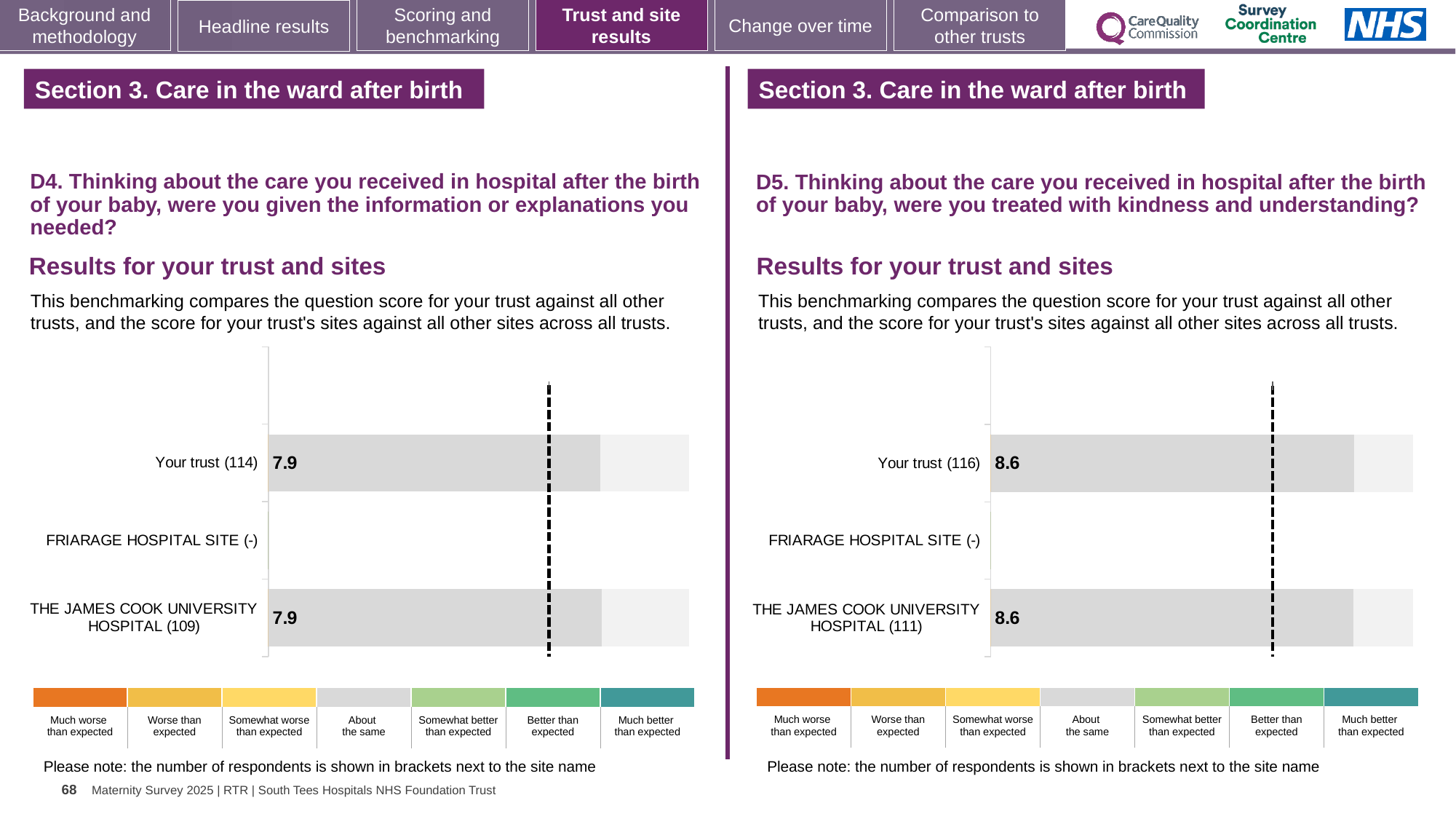
How many categories (rows) are listed on the right chart (D5)? 3 How many benchmark categories are shown in the colour key below the left chart (D4)? 7 What type of chart is used in the left chart (D4)? Bar chart How many respondents are shown in brackets for Your trust in the right chart (D5)? 116 In the left chart (D4), what is the score for Your trust (114)? 7.9 In the left chart (D4), which category has no bar plotted? FRIARAGE HOSPITAL SITE (-) In the right chart (D5), what is the difference between the score for Your trust (116) and the score for THE JAMES COOK UNIVERSITY HOSPITAL (111)? 0 In the right chart (D5), what is the score for THE JAMES COOK UNIVERSITY HOSPITAL (111)? 8.6 In the left chart (D4), what is the score for THE JAMES COOK UNIVERSITY HOSPITAL (109)? 7.9 In the left chart (D4), what is the difference between the score for Your trust (114) and the score for THE JAMES COOK UNIVERSITY HOSPITAL (109)? 0 How many categories (rows) are listed on the left chart (D4)? 3 In the right chart (D5), what is the score for Your trust (116)? 8.6